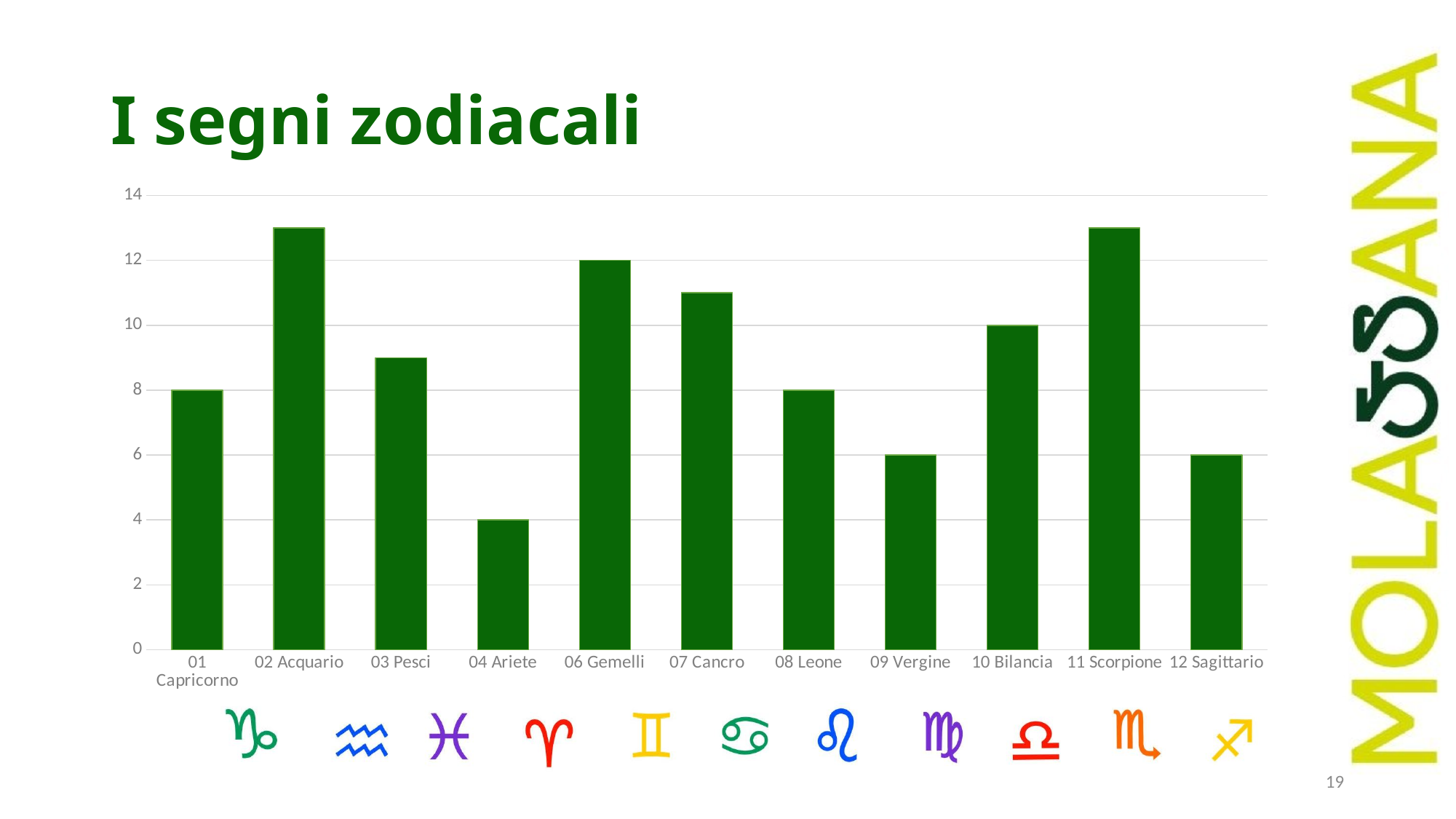
Is the value for 02 Acquario greater or less than 12? greater What is the value for 06 Gemelli? 12 What is the value for 09 Vergine? 6 What is the title of the slide containing the chart? I segni zodiacali Which has a larger value, 10 Bilancia or 09 Vergine? 10 Bilancia What is the value for 10 Bilancia? 10 Which zodiac sign has the lowest value? 04 Ariete What is the value for 04 Ariete? 4 What kind of chart is shown on the slide? bar chart What is the difference between the values for 06 Gemelli and 04 Ariete? 8 How many zodiac sign categories are plotted on the chart? 11 What is the value for 01 Capricorno? 8